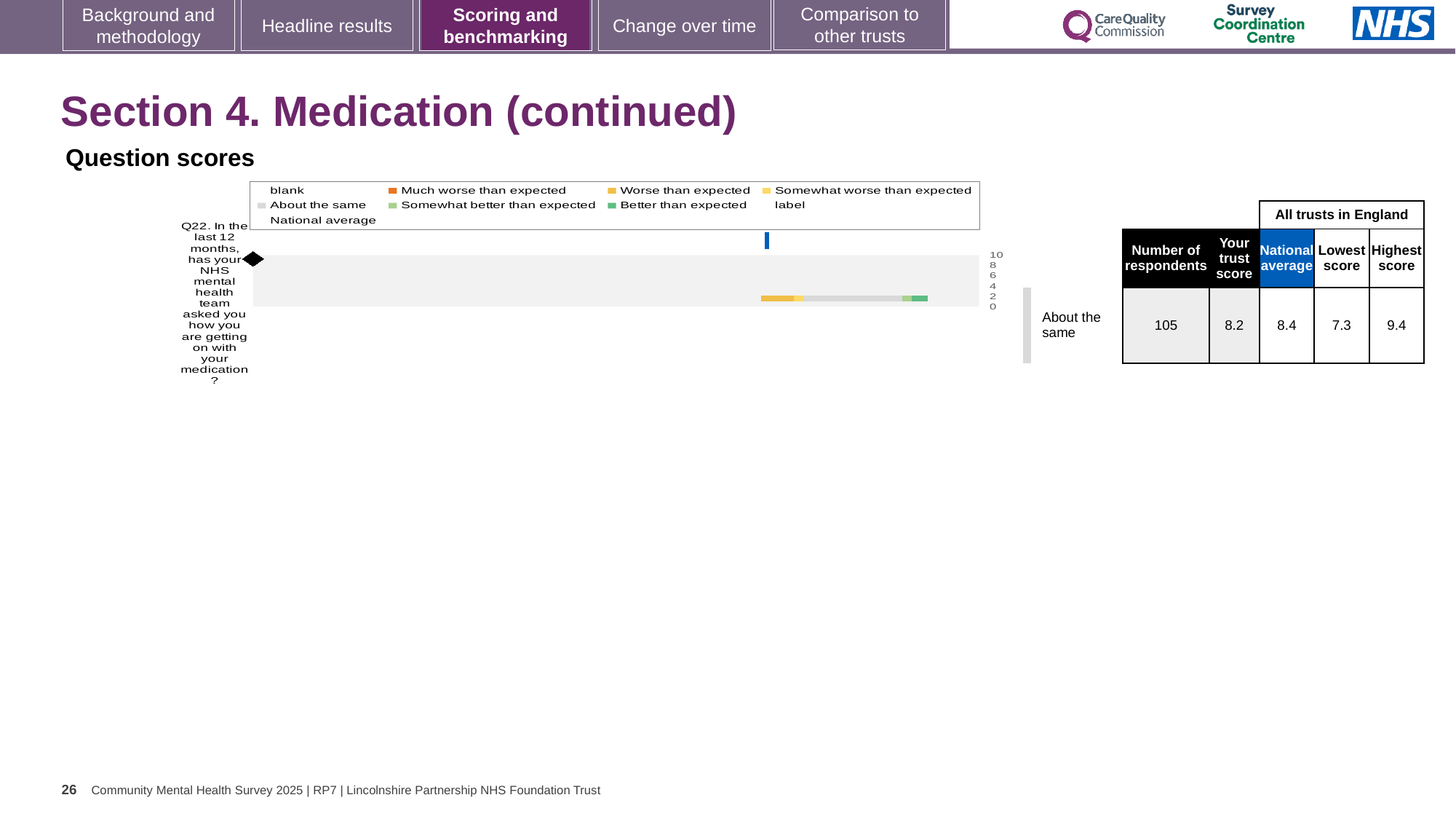
For Q22, what is the difference between the highest and lowest scores among all trusts in England? 2.1 In the table beside the chart, what is the trust's score for Q22? 8.2 For Q22, which is larger: the trust's score or the national average? National average What benchmark category is shown for Q22 next to the chart? About the same In the table beside the chart, what is the lowest score among all trusts in England for Q22? 7.3 What kind of chart is shown under 'Question scores'? bar chart In the table beside the chart, what is the number of respondents for Q22? 105 Which question is plotted in the Question scores chart? Q22 In the table beside the chart, what is the highest score among all trusts in England for Q22? 9.4 How many questions are plotted in the Question scores chart? 1 In the table beside the chart, what is the national average score for Q22? 8.4 For Q22, how much higher is the national average than the trust's score? 0.2